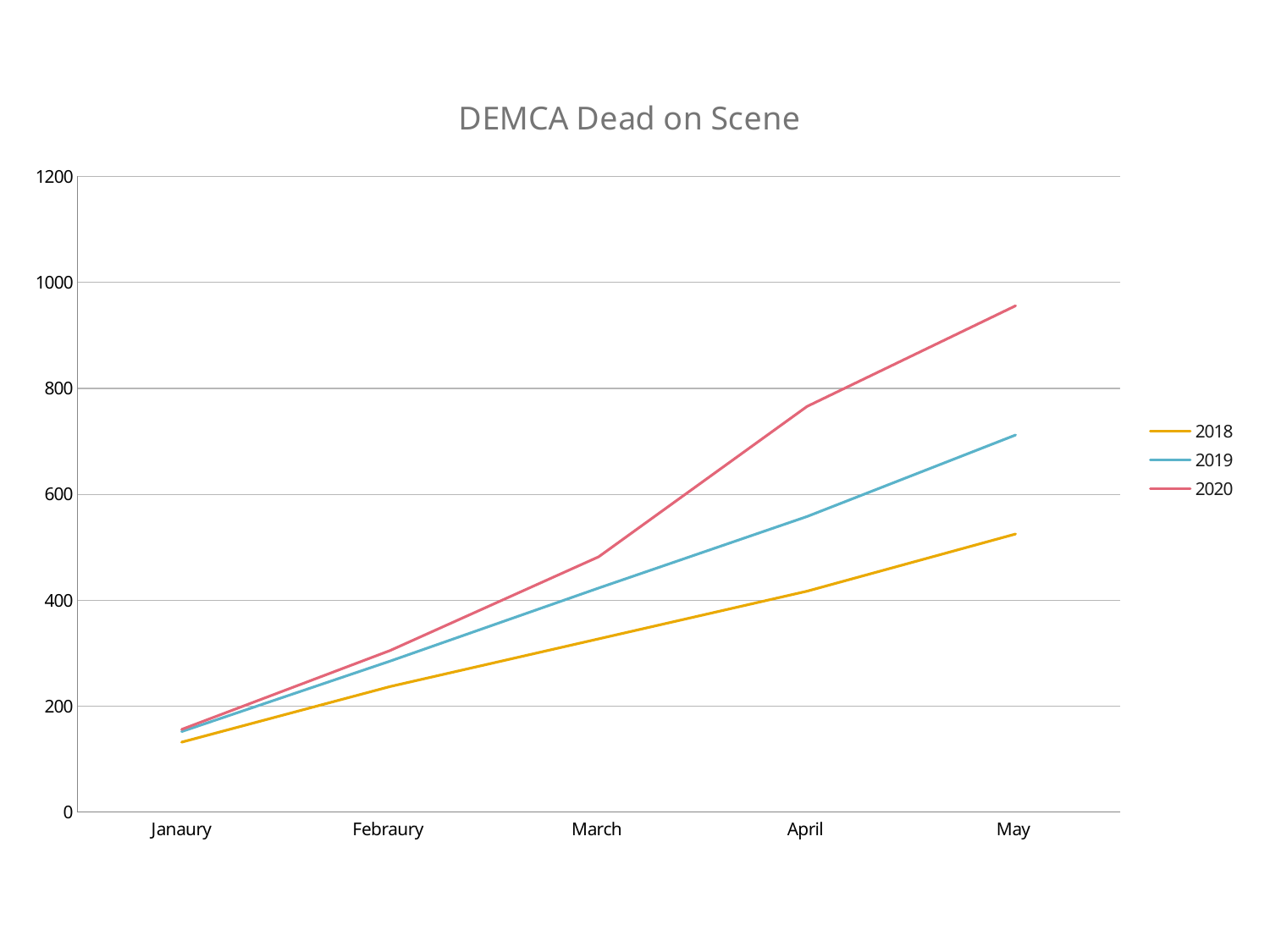
What is the title of the chart? DEMCA Dead on Scene Which series has the lowest value in May? 2018 How many series does the legend list? 3 Is the value for 2020 in April greater or less than 600? greater What kind of chart is shown on the slide? line chart Is the value for 2020 in May greater or less than 1000? less Which is larger in April, the value for 2019 or the value for 2018? 2019 How many months are shown on the x axis? 5 Is the value for 2018 in May greater or less than 600? less Do the values for the 2019 series rise or fall from January to May? rise In which month does the 2020 series reach its highest value? May Which series has the highest value in May? 2020